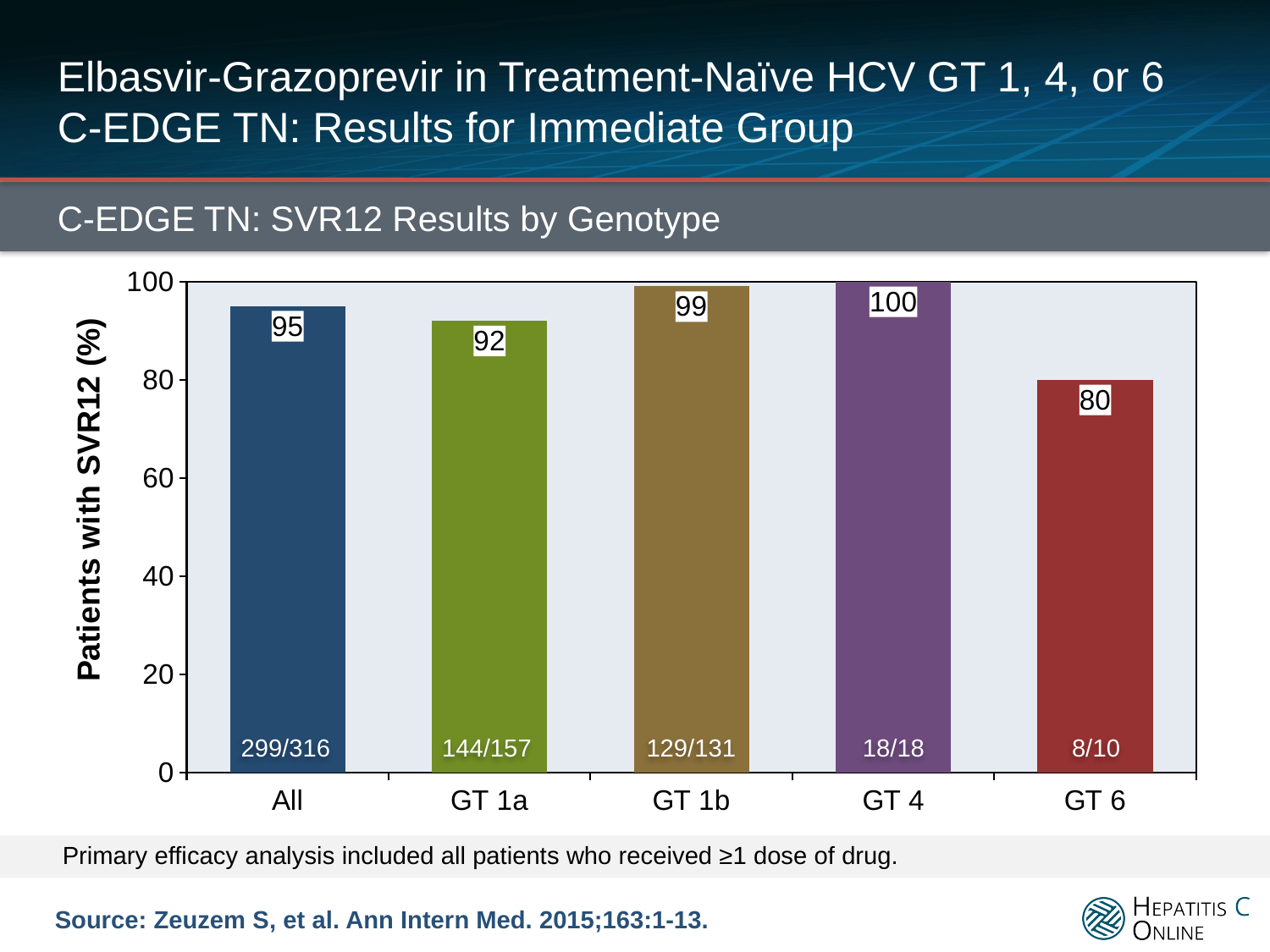
Which has a higher SVR12 rate, GT 1a or GT 6? GT 1a What fraction of patients is shown inside the GT 1b bar? 129/131 What is the difference in SVR12 rate between GT 1b and GT 1a? 7 What is the SVR12 rate for GT 6? 80 What is the SVR12 rate for the All group? 95 Which genotype group has the lowest SVR12 rate? GT 6 What is the SVR12 rate for GT 1a? 92 Is the SVR12 rate for GT 6 greater or less than 60? greater What type of chart is shown? Bar chart Which genotype group has the highest SVR12 rate? GT 4 What is the label of the y axis? Patients with SVR12 (%) How many genotype groups are shown on the x axis? 5